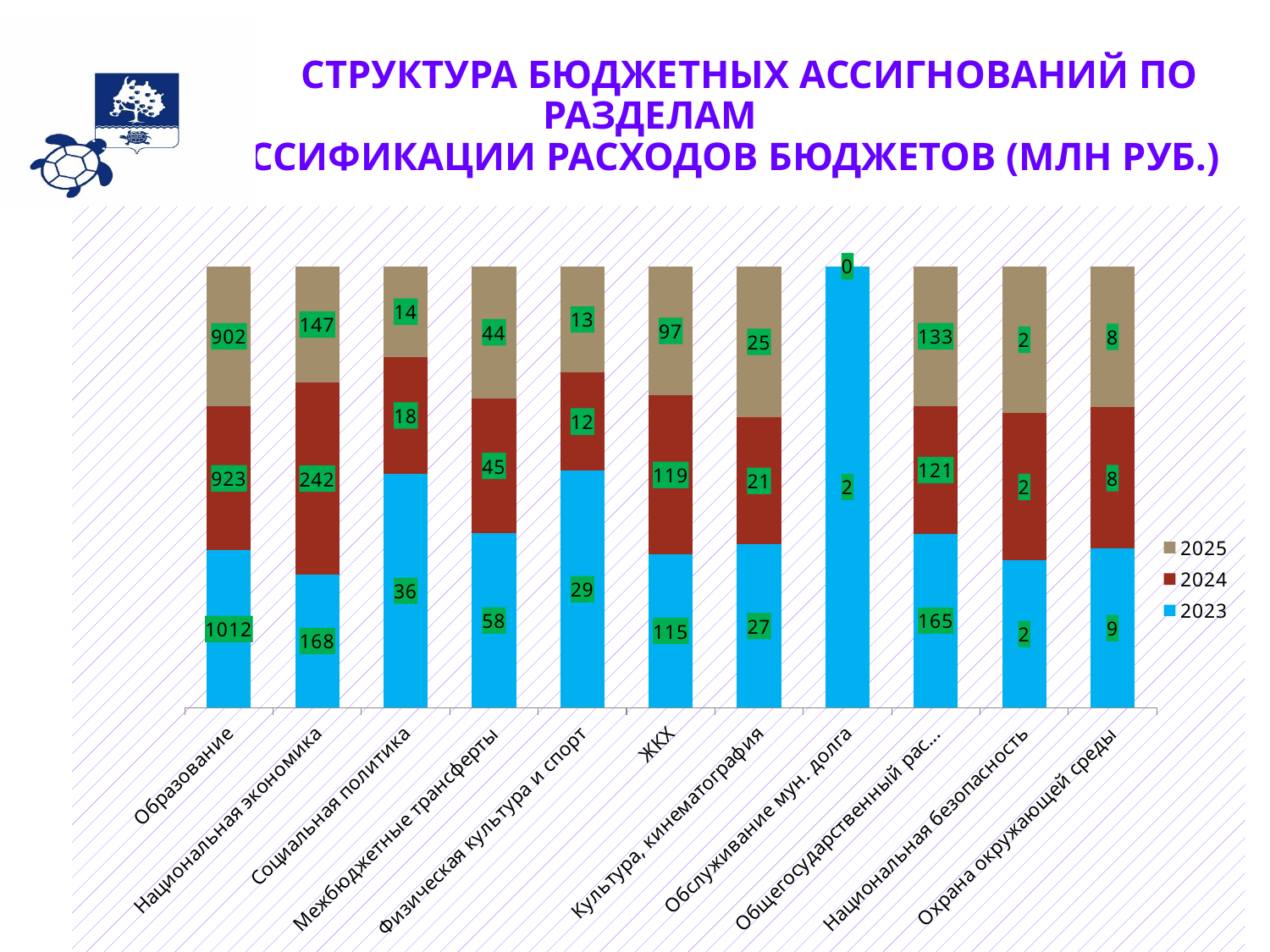
What is the 2025 value for Охрана окружающей среды? 8 What is the 2024 value for Национальная экономика? 242 How many categories are shown on the x axis? 11 How many series does the legend list? 3 What is the 2025 value for ЖКХ? 97 What is the 2023 value for Межбюджетные трансферты? 58 What kind of chart is shown on the slide? Stacked bar chart What is the total of the three labelled values for Национальная безопасность? 6 Which is larger for Социальная политика: the 2023 value or the 2024 value? 2023 What is the difference between the 2023 and 2024 values for Образование? 89 Which category has the highest 2023 value? Образование What is the 2023 value for Образование? 1012